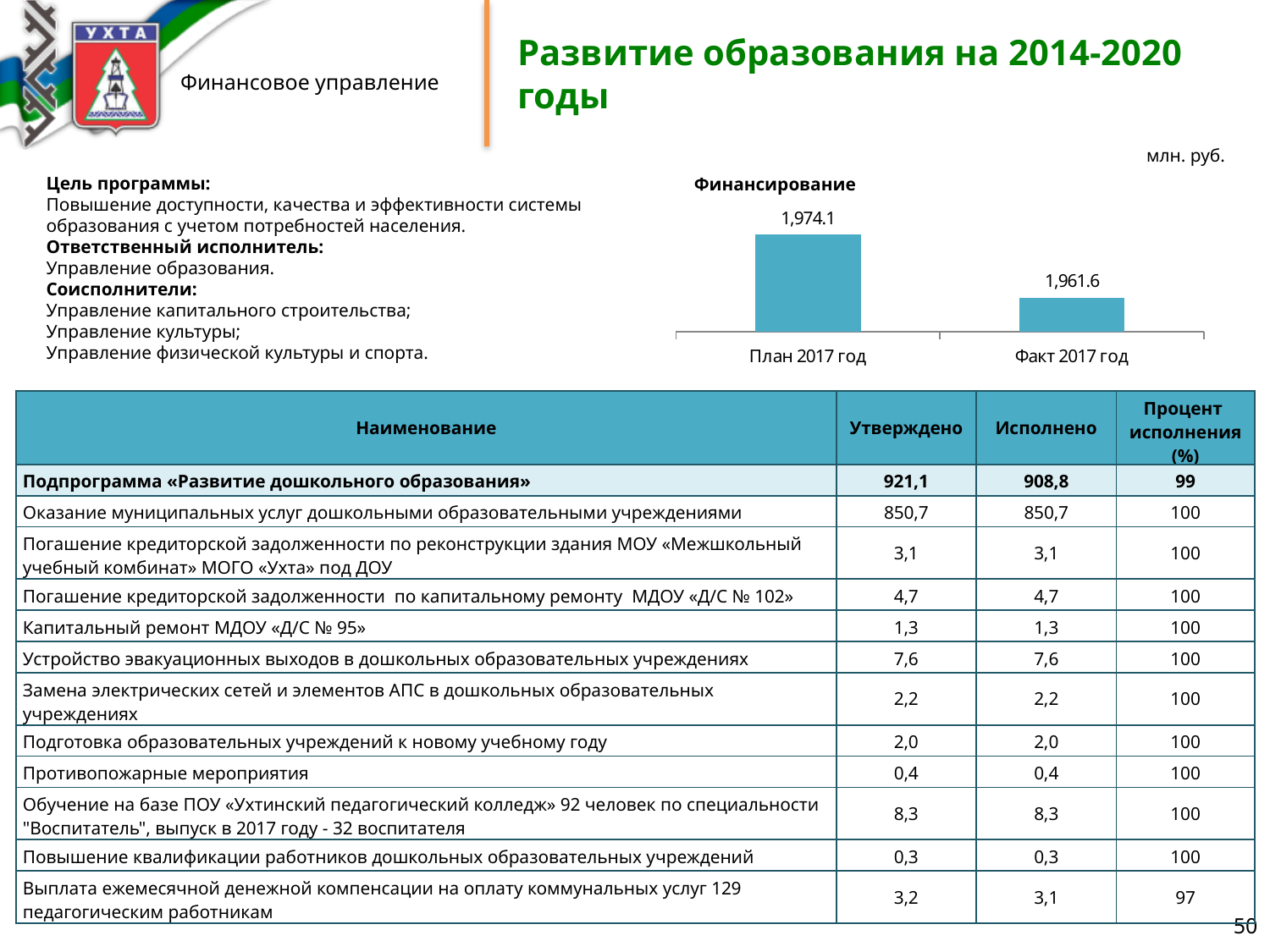
How many bars are shown in the Финансирование chart? 2 What is the value for Факт 2017 год in the Финансирование chart? 1,961.6 What is the title of the chart on the slide? Финансирование Do the values in the Финансирование chart rise or fall from План 2017 год to Факт 2017 год? fall What unit is indicated for the values in the Финансирование chart? млн. руб. Which category has the lowest value in the Финансирование chart? Факт 2017 год What is the difference between the План 2017 год and Факт 2017 год values in the Финансирование chart? 12.5 In the Финансирование chart, which is larger: План 2017 год or Факт 2017 год? План 2017 год What type of chart is the Финансирование chart? bar chart Which category has the highest value in the Финансирование chart? План 2017 год What is the value for План 2017 год in the Финансирование chart? 1,974.1